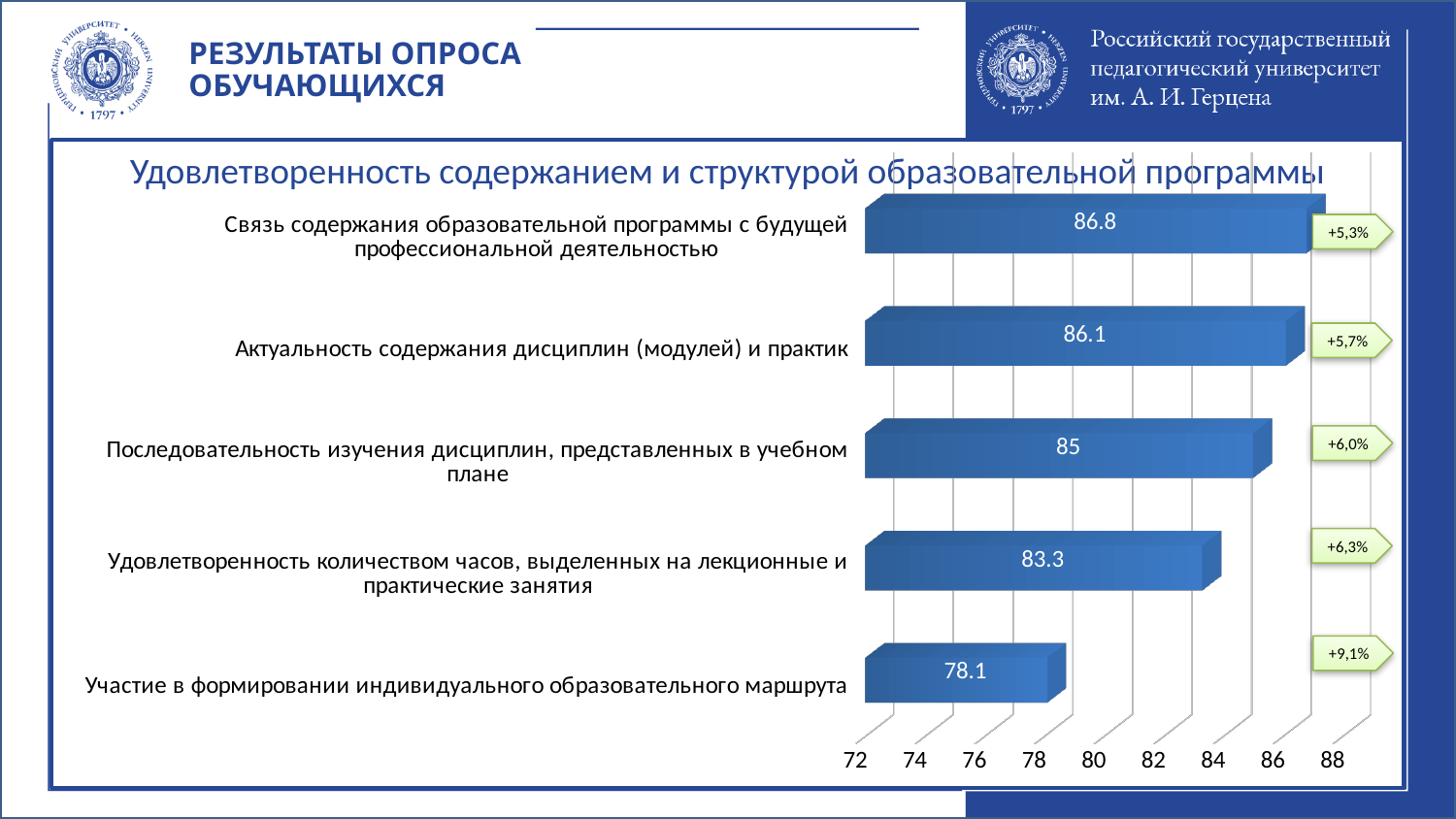
What is the difference between the values for "Последовательность изучения дисциплин, представленных в учебном плане" and "Участие в формировании индивидуального образовательного маршрута"? 6.9 What is the value for "Участие в формировании индивидуального образовательного маршрута"? 78.1 Which is larger: the value for "Последовательность изучения дисциплин, представленных в учебном плане" or for "Удовлетворенность количеством часов, выделенных на лекционные и практические занятия"? Последовательность изучения дисциплин, представленных в учебном плане What is the value for "Связь содержания образовательной программы с будущей профессиональной деятельностью"? 86.8 What is the value for "Актуальность содержания дисциплин (модулей) и практик"? 86.1 Which category has the highest value? Связь содержания образовательной программы с будущей профессиональной деятельностью How many categories are shown in the chart? 5 Which category has the lowest value? Участие в формировании индивидуального образовательного маршрута What kind of chart is shown on the slide? bar chart What is the title of the chart? Удовлетворенность содержанием и структурой образовательной программы What is the value for "Удовлетворенность количеством часов, выделенных на лекционные и практические занятия"? 83.3 Is the value for "Участие в формировании индивидуального образовательного маршрута" greater or less than 80? less